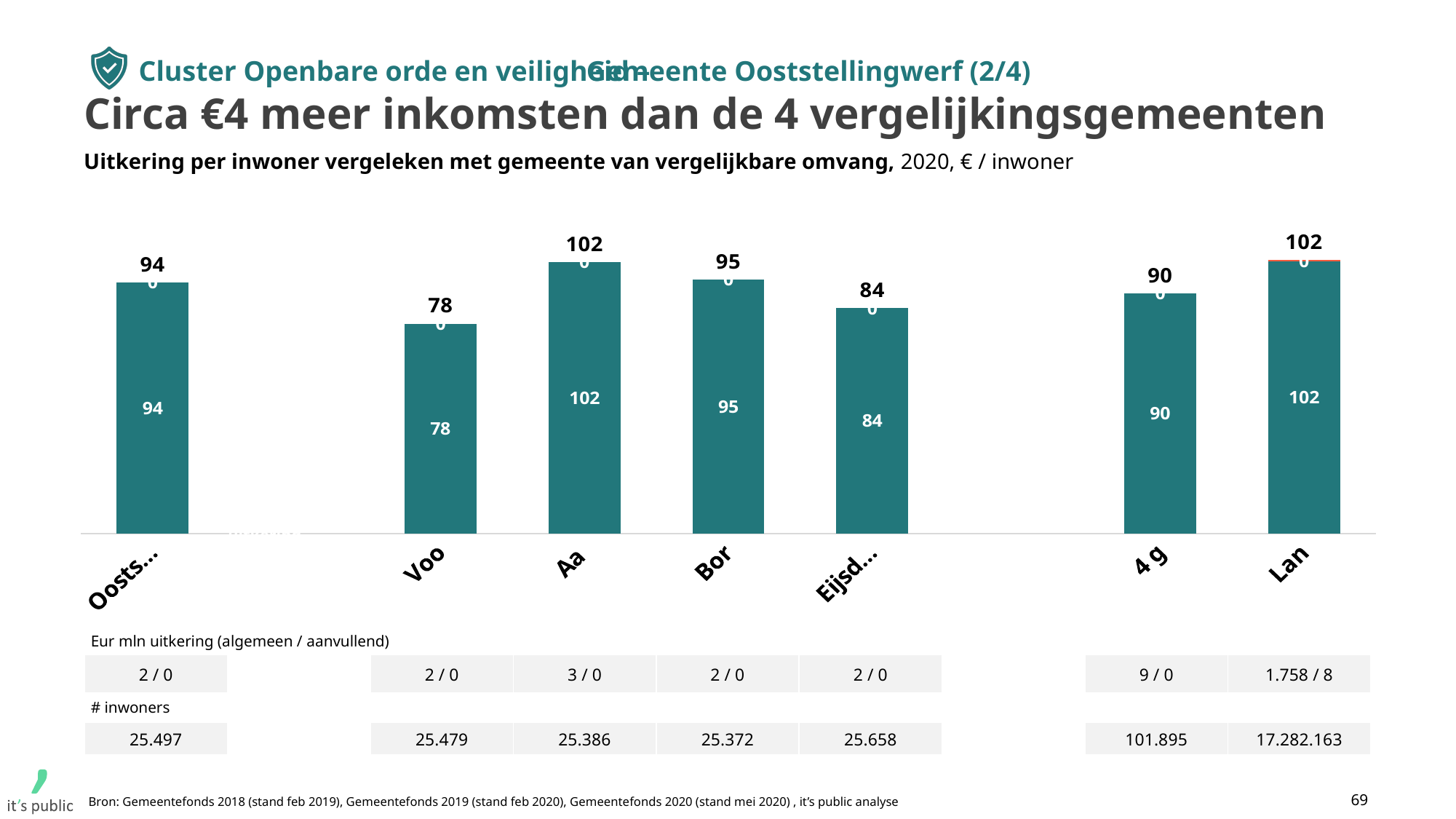
Which category has the lowest value? Voo How many bars are shown in the chart? 7 What is the difference between the values for Aa and Voo? 24 What is the value for Aa? 102 What is the value for the first bar (Oosts...)? 94 What is the value for Bor? 95 What is the difference between the values for Oosts... and 4 g? 4 What is the value for 4 g? 90 What is the value for Voo? 78 Which is larger, the value for Bor or the value for 4 g? Bor What kind of chart is shown on the slide? bar chart What is the value for Eijsd...? 84